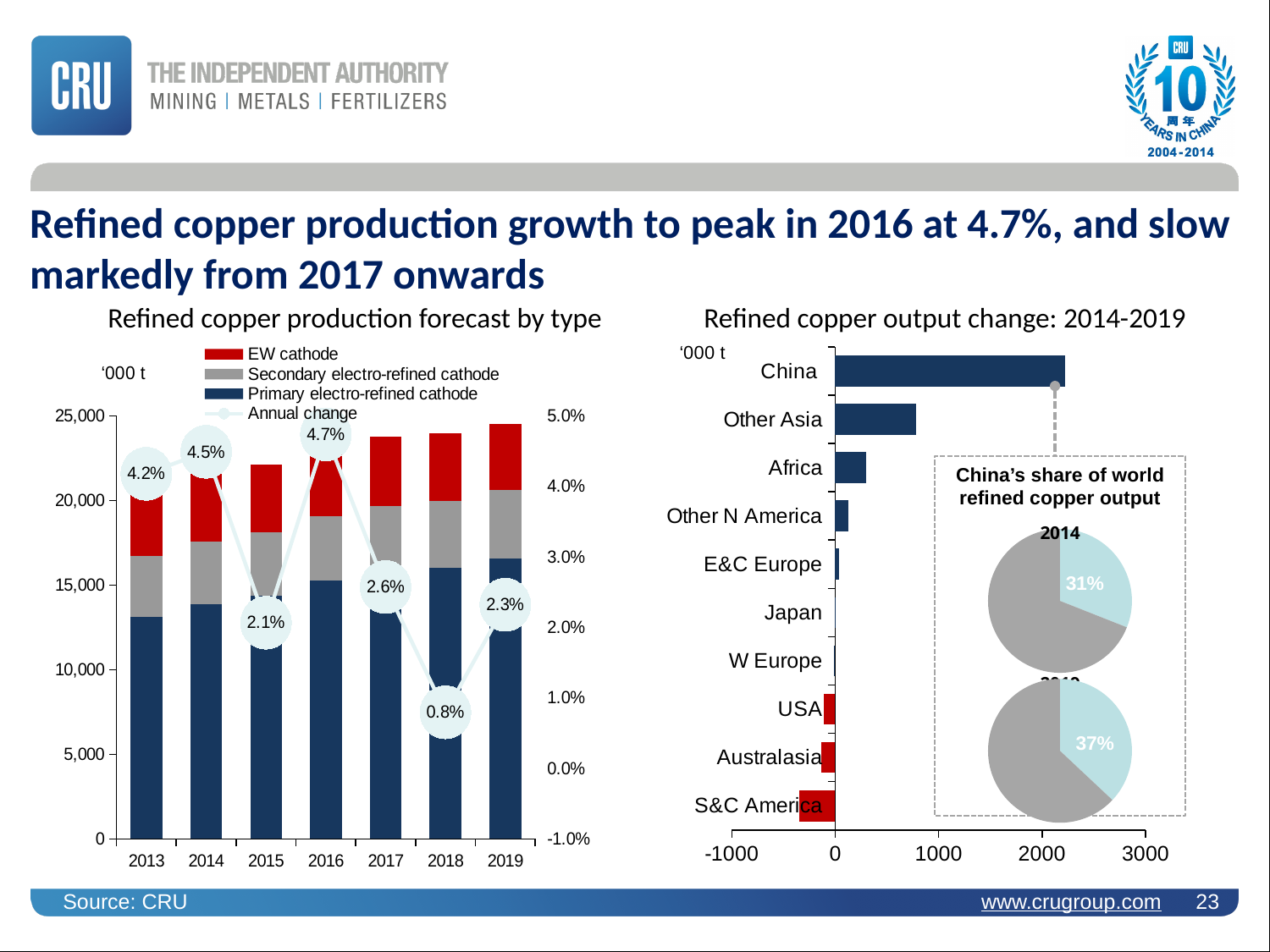
According to the pie chart on the right-hand side of the slide, what was China's share of world refined copper output in 2014? 31% In the 'Refined copper production forecast by type' chart, what is the difference between the annual change in 2016 and in 2018? 3.9 percentage points In the 'Refined copper production forecast by type' chart, which year has the highest annual change? 2016 In the 'Refined copper production forecast by type' chart, which year has the lowest annual change? 2018 In the 'Refined copper output change: 2014-2019' chart, which region has the largest output change? China How many series does the legend of the 'Refined copper production forecast by type' chart list? 4 In the 'Refined copper production forecast by type' chart, which year has the larger annual change, 2014 or 2015? 2014 In the 'Refined copper production forecast by type' chart, what is the annual change shown for 2018? 0.8% In the 'Refined copper output change: 2014-2019' chart, is the value for China greater or less than 2000? greater How many regions are listed in the 'Refined copper output change: 2014-2019' chart? 10 In the 'Refined copper production forecast by type' chart, what is the annual change shown for 2016? 4.7% How many years are shown on the x axis of the 'Refined copper production forecast by type' chart? 7